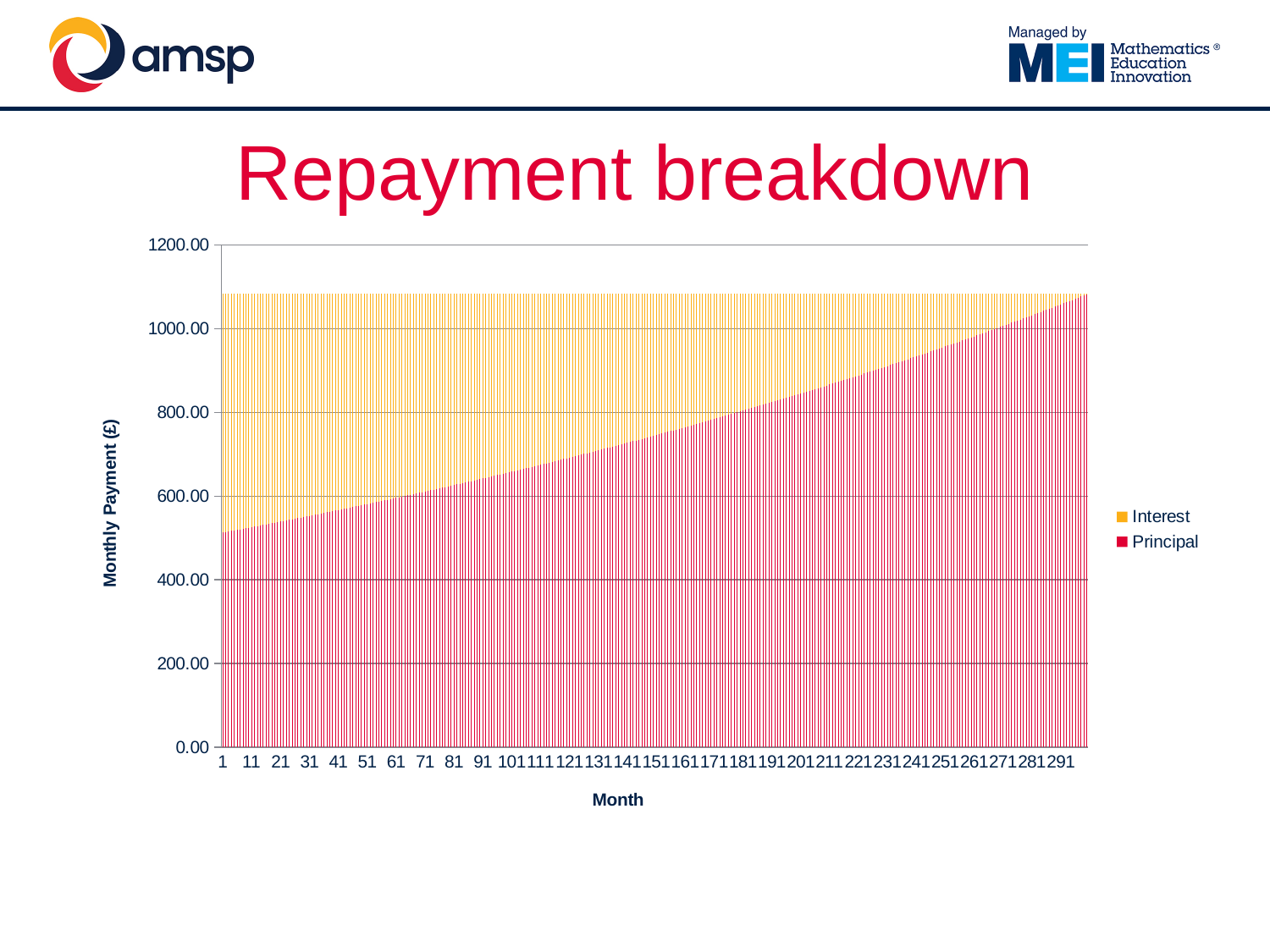
What are the two series named in the legend? Interest and Principal What is the title of the chart? Repayment breakdown Does the Principal portion of the monthly payment rise or fall as the month number increases? rise Is the Principal value at month 291 greater or less than 1000? greater What kind of chart is shown on the slide? stacked bar chart At month 291, which is larger, the Interest portion or the Principal portion? Principal Is the Interest value at month 201 greater or less than 400? less Does the Interest portion of the monthly payment rise or fall as the month number increases? fall How many series does the legend list? 2 Is the Principal value at month 1 greater or less than 600? less